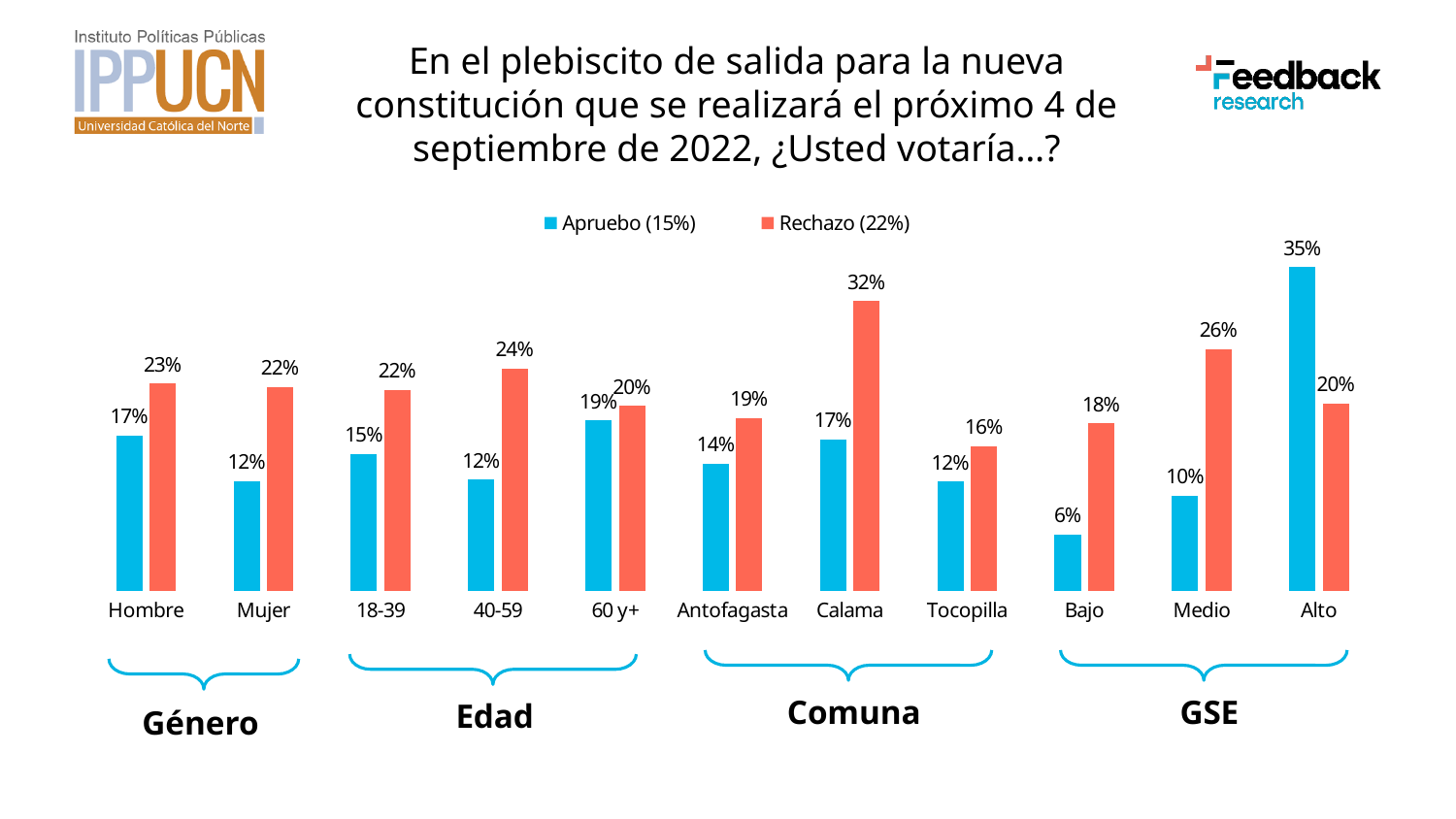
For Alto, which is larger: Apruebo or Rechazo? Apruebo What is the Rechazo value for Calama? 32% What is the difference between the Rechazo and Apruebo values for Medio? 16% Which category has the highest Apruebo value? Alto What is the Apruebo value for Hombre? 17% How many series does the legend list? 2 What is the Apruebo value for Bajo? 6% What kind of chart is shown on the slide? Bar chart What are the two legend entries of the chart? Apruebo (15%) and Rechazo (22%) What is the difference between the Rechazo values for Calama and Antofagasta? 13% How many categories are shown on the x axis? 11 Which category has the lowest Rechazo value? Tocopilla